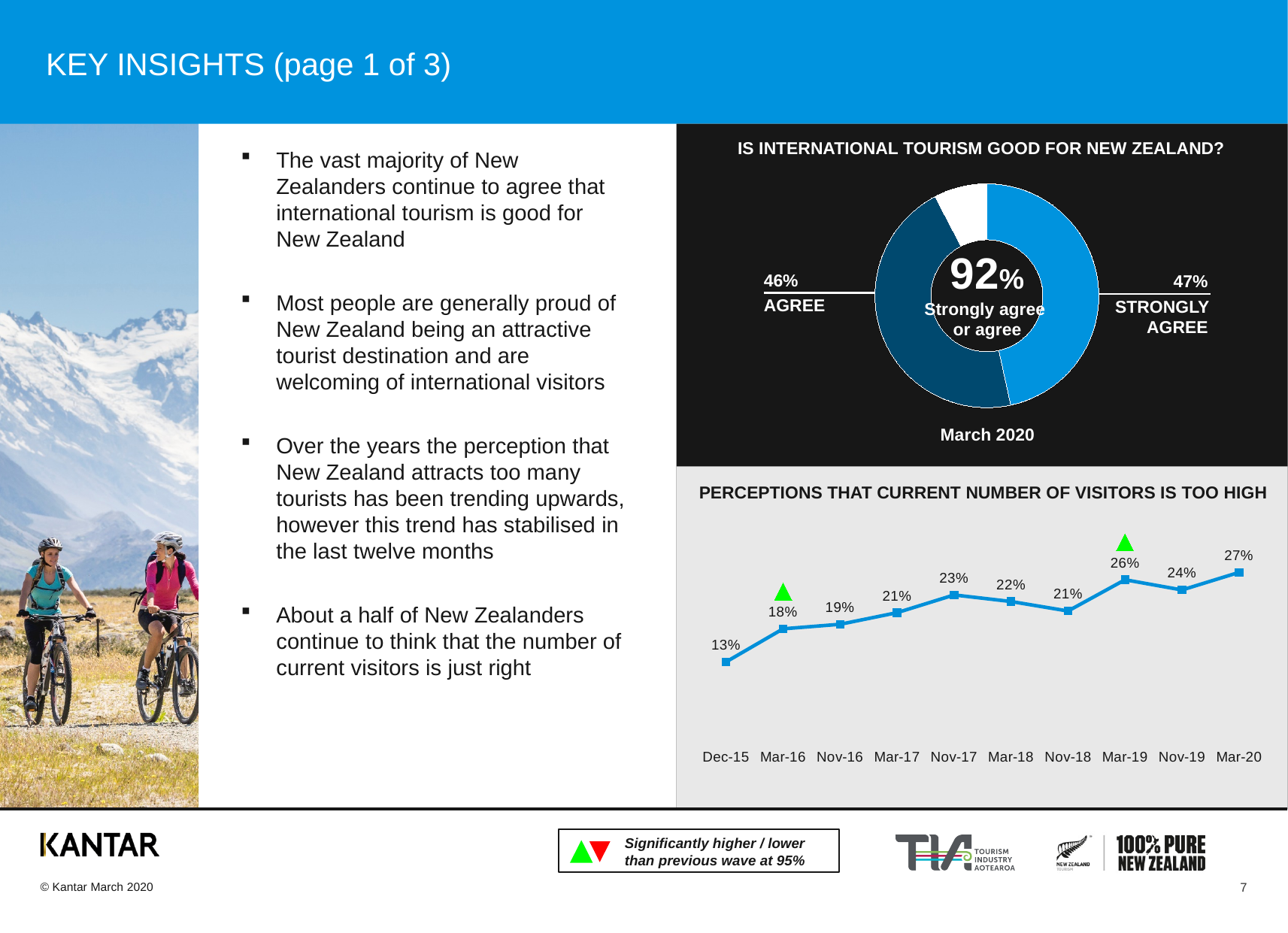
In the chart titled 'PERCEPTIONS THAT CURRENT NUMBER OF VISITORS IS TOO HIGH', what is the difference between the Mar-20 value and the Dec-15 value? 14 percentage points In the chart titled 'PERCEPTIONS THAT CURRENT NUMBER OF VISITORS IS TOO HIGH', what is the value for Dec-15? 13% How many time periods are plotted in the chart titled 'PERCEPTIONS THAT CURRENT NUMBER OF VISITORS IS TOO HIGH'? 10 In the chart titled 'PERCEPTIONS THAT CURRENT NUMBER OF VISITORS IS TOO HIGH', which period has the highest value? Mar-20 In the chart titled 'IS INTERNATIONAL TOURISM GOOD FOR NEW ZEALAND?', what is the combined percentage who strongly agree or agree? 92% In the chart titled 'PERCEPTIONS THAT CURRENT NUMBER OF VISITORS IS TOO HIGH', what is the value for Nov-17? 23% What kind of chart is the one titled 'PERCEPTIONS THAT CURRENT NUMBER OF VISITORS IS TOO HIGH'? Line chart In the chart titled 'PERCEPTIONS THAT CURRENT NUMBER OF VISITORS IS TOO HIGH', which period has the lowest value? Dec-15 In the chart titled 'PERCEPTIONS THAT CURRENT NUMBER OF VISITORS IS TOO HIGH', which is larger, the value for Mar-19 or the value for Nov-19? Mar-19 In the chart titled 'IS INTERNATIONAL TOURISM GOOD FOR NEW ZEALAND?', what percentage strongly agree? 47% In the chart titled 'PERCEPTIONS THAT CURRENT NUMBER OF VISITORS IS TOO HIGH', what is the value for Mar-20? 27% In the chart titled 'PERCEPTIONS THAT CURRENT NUMBER OF VISITORS IS TOO HIGH', do the values generally rise or fall from Dec-15 to Mar-20? Rise